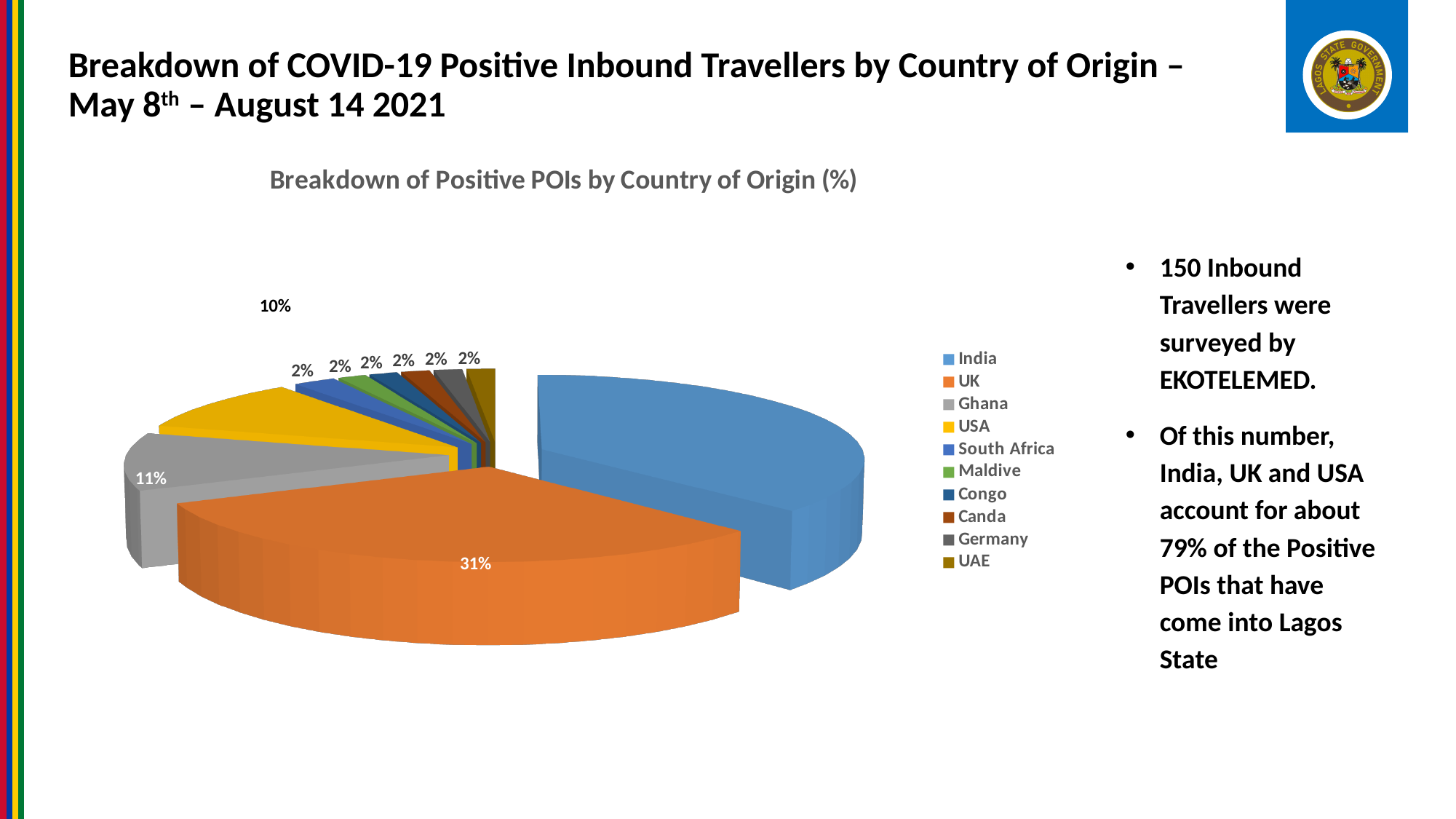
What percentage of positive POIs came from Germany? 2% What percentage of positive POIs came from the USA? 10% What colour is the slice representing the UK? orange How many percentage points larger is the UK share than the Ghana share? 20% What percentage of positive POIs came from the UK? 31% What is the difference between the Ghana share and the USA share? 1% What percentage of positive POIs came from Ghana? 11% What is the title of the chart? Breakdown of Positive POIs by Country of Origin (%) How many countries are listed in the chart legend? 10 Which has a larger share of positive POIs, the UK or Ghana? UK What kind of chart is shown on the slide? pie chart Which country has the largest slice of the pie? India